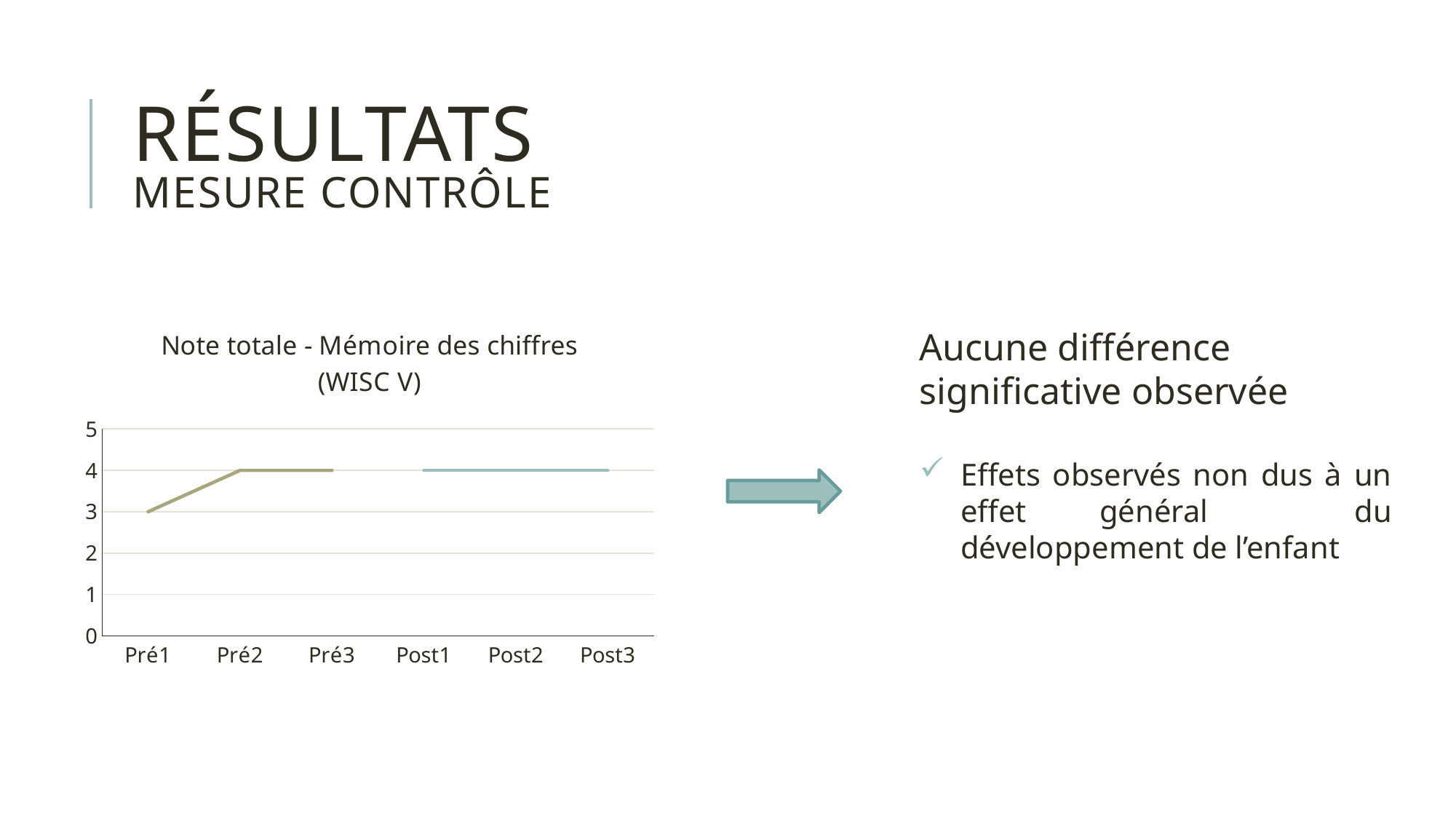
What kind of chart is shown on the slide? line chart How many categories are shown on the x axis of the chart? 6 Which category has the lowest value? Pré1 Which is larger, the value for Pré1 or the value for Pré3? Pré3 What is the title of the chart? Note totale - Mémoire des chiffres (WISC V) Do the values rise or fall from Pré1 to Pré2? rise What is the value for Post3? 4 What is the difference between the values for Pré2 and Pré1? 1 Is the value for Pré1 greater or less than 4? less What is the highest value shown on the y axis? 5 What is the value for Pré1? 3 What is the value for Pré2? 4